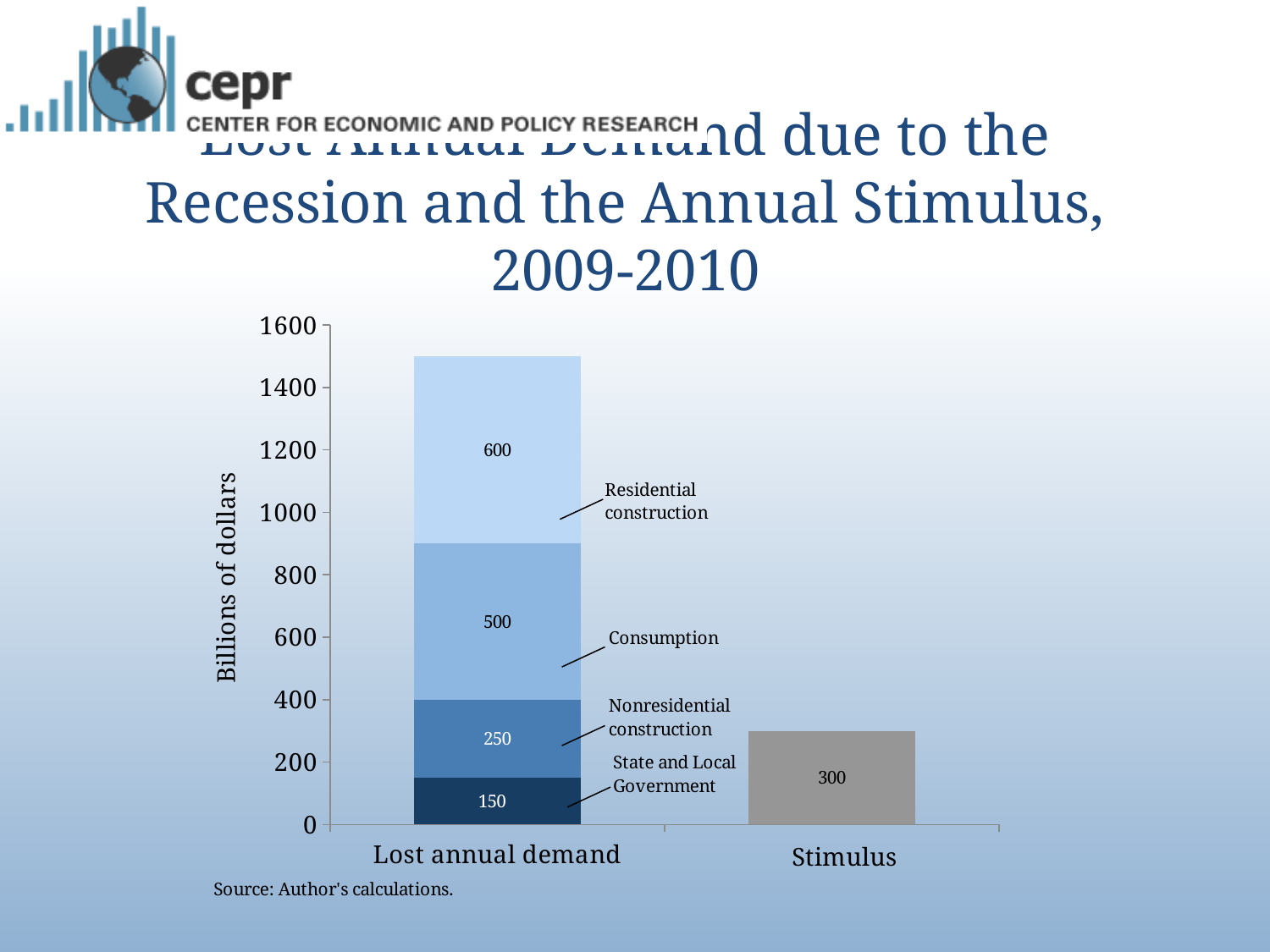
What is the value of the State and Local Government segment in the Lost annual demand bar? 150 What is the value of the Consumption segment in the Lost annual demand bar? 500 Which segment of the Lost annual demand bar is the smallest? State and Local Government How much larger is the Residential construction segment than the Consumption segment? 100 Which segment of the Lost annual demand bar is the largest? Residential construction Which bar is taller, Lost annual demand or Stimulus? Lost annual demand What is the total of the stacked Lost annual demand bar? 1500 What is the value of the Nonresidential construction segment in the Lost annual demand bar? 250 What is the label on the vertical axis? Billions of dollars What is the value of the Residential construction segment in the Lost annual demand bar? 600 What is the value shown for the Stimulus bar? 300 How many categories are shown on the x axis? 2